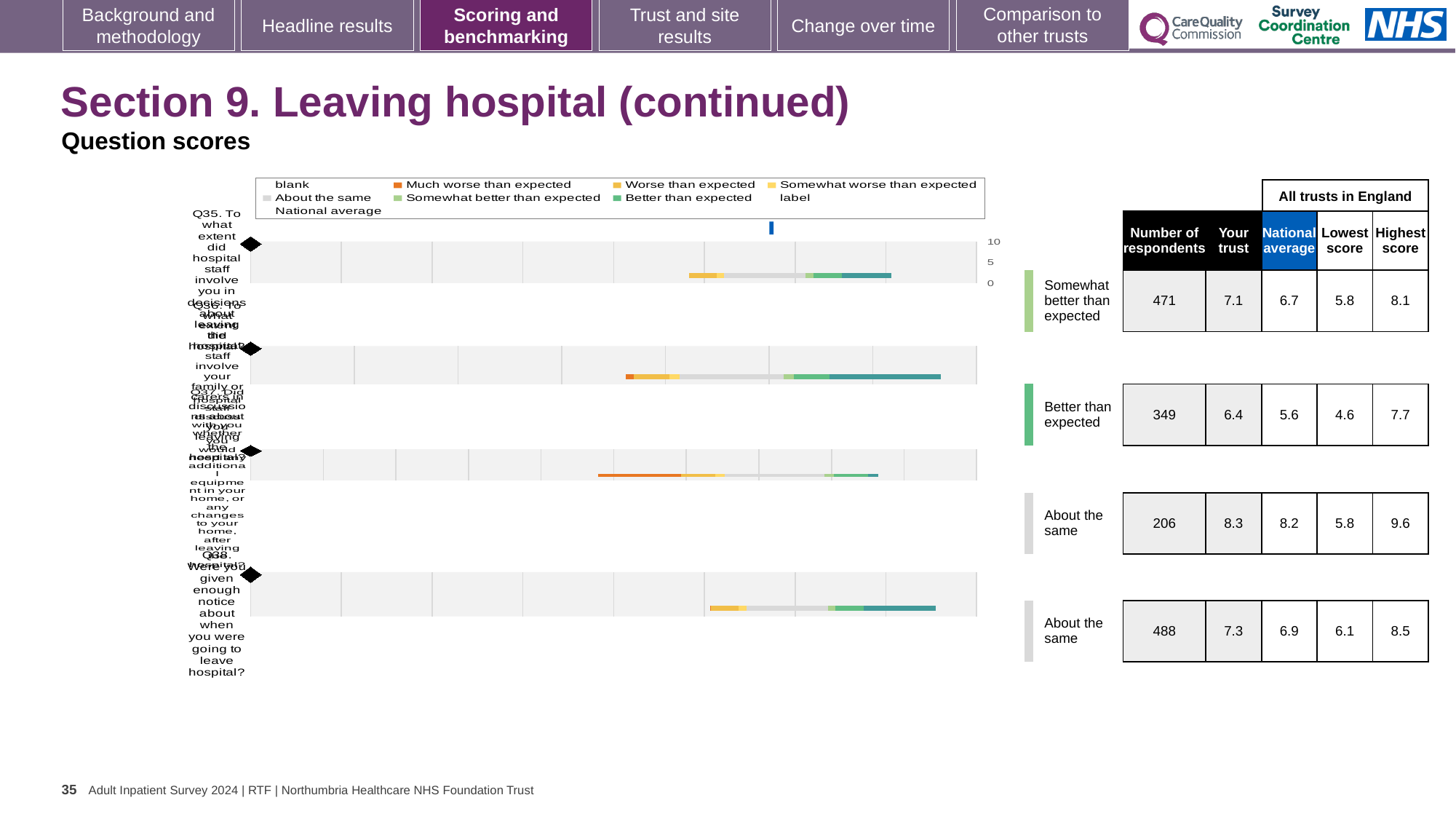
Which question numbers are plotted in the chart? Q35, Q36, Q37, Q38 What is the lowest 'Lowest score' value shown in the table? 4.6 In the table, what is the difference between the 'Your trust' score and the national average in the first row (7.1 vs 6.7)? 0.4 What type of chart is shown on the slide? bar chart Which row of the table has the highest 'Your trust' score? The row with 206 respondents (About the same), 8.3 How many survey questions (bars) are plotted in the chart? 4 In the table row with 206 respondents, which is larger: the 'Your trust' score or the national average? Your trust In the table, what is the highest score in the row with 206 respondents? 9.6 In the table, what is the national average in the row labelled 'Better than expected'? 5.6 In the table, how many respondents are listed in the last row? 488 In the table, what is the 'Your trust' score in the first row (Somewhat better than expected)? 7.1 In the table, how many respondents are listed in the row labelled 'Better than expected'? 349